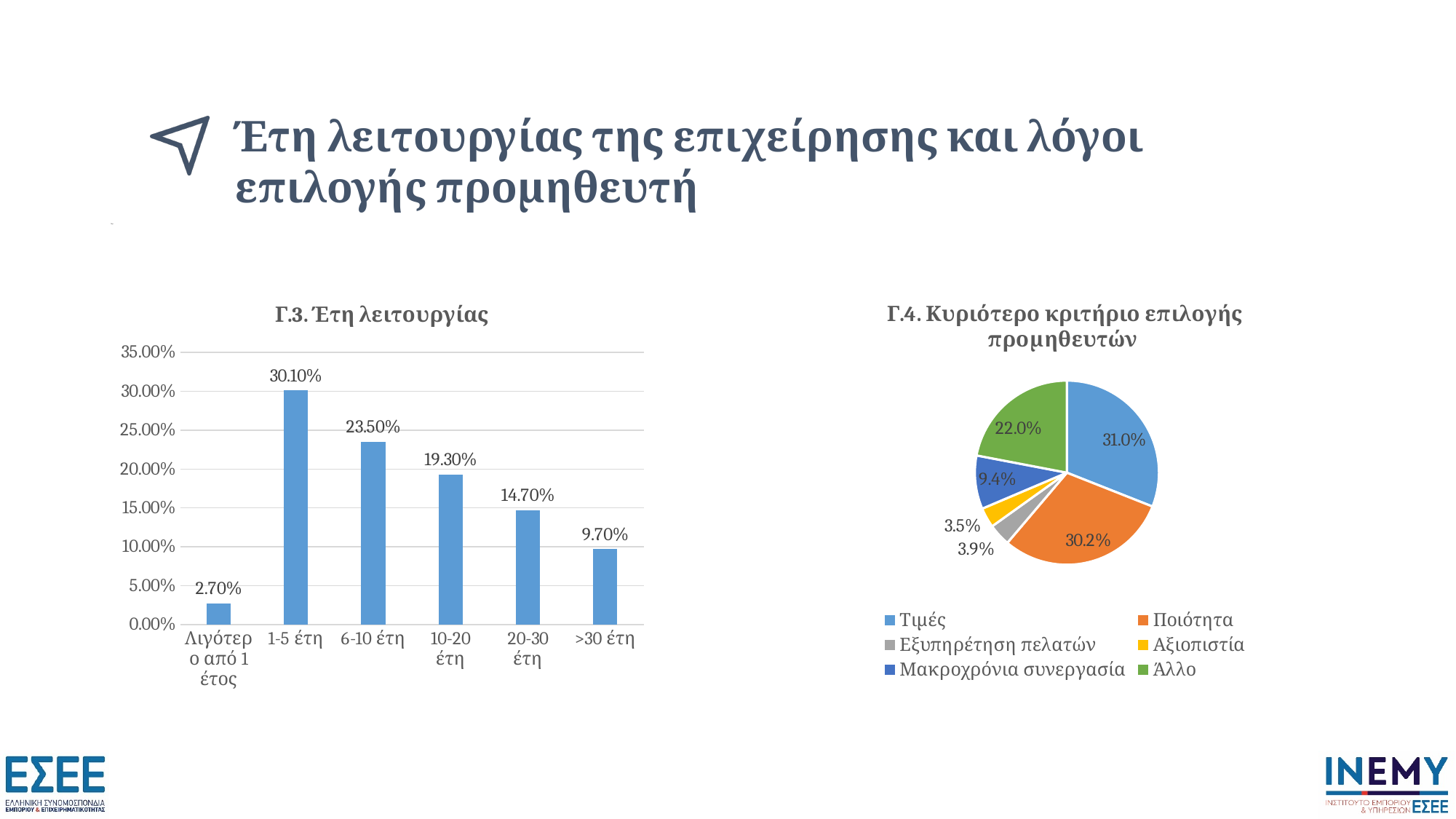
In the chart 'Γ.3. Έτη λειτουργίας', how many categories are shown on the x axis? 6 In the chart 'Γ.3. Έτη λειτουργίας', what is the value for '>30 έτη'? 9.70% In the pie chart 'Γ.4. Κυριότερο κριτήριο επιλογής προμηθευτών', which criterion has the smallest share? Αξιοπιστία In the chart 'Γ.3. Έτη λειτουργίας', which category has the highest value? 1-5 έτη In the chart 'Γ.3. Έτη λειτουργίας', what is the value for '1-5 έτη'? 30.10% In the chart 'Γ.3. Έτη λειτουργίας', which category has the lowest value? Λιγότερο από 1 έτος In the pie chart 'Γ.4. Κυριότερο κριτήριο επιλογής προμηθευτών', what share does 'Ποιότητα' have? 30.2% How many entries does the legend of the pie chart 'Γ.4. Κυριότερο κριτήριο επιλογής προμηθευτών' list? 6 In the chart 'Γ.3. Έτη λειτουργίας', do the values rise or fall from '1-5 έτη' to '>30 έτη'? fall In the pie chart 'Γ.4. Κυριότερο κριτήριο επιλογής προμηθευτών', which is larger, 'Τιμές' or 'Ποιότητα'? Τιμές In the chart 'Γ.3. Έτη λειτουργίας', what is the difference between the values for '6-10 έτη' and '10-20 έτη'? 4.20% What kind of chart is 'Γ.3. Έτη λειτουργίας'? bar chart